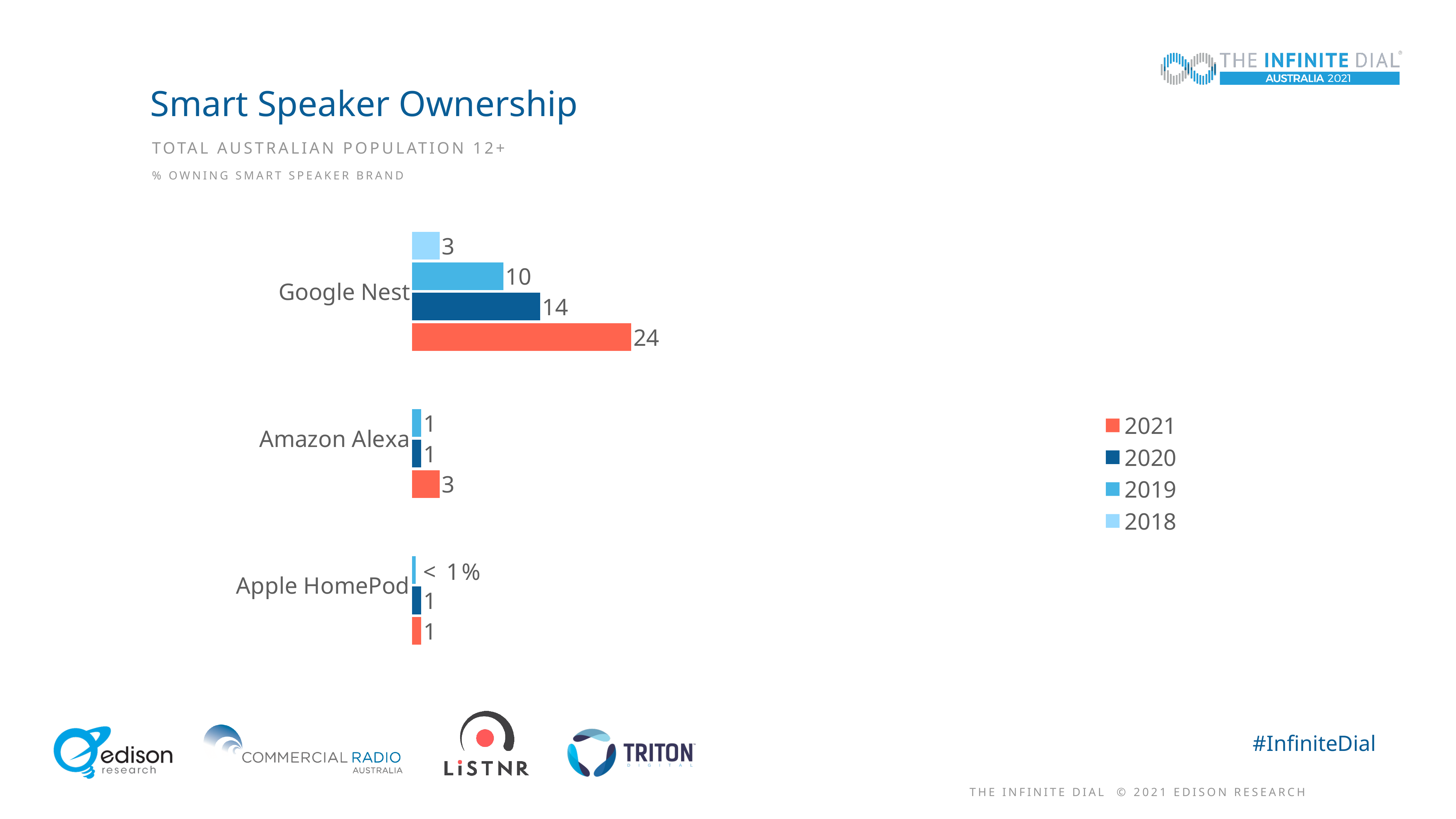
What kind of chart is shown on the slide? bar chart What is the difference between the Google Nest values for 2021 and 2020? 10 What is the difference between the Google Nest values for 2019 and 2018? 7 What is the value for Apple HomePod in 2019? < 1% Do the Google Nest values rise or fall from 2018 to 2021? rise Which is larger, the 2021 value for Amazon Alexa or the 2021 value for Apple HomePod? Amazon Alexa What is the value for Amazon Alexa in 2021? 3 Which brand has the highest value in 2021? Google Nest How many brands are shown on the chart? 3 What is the value for Google Nest in 2018? 3 How many series does the legend list? 4 What is the value for Google Nest in 2021? 24